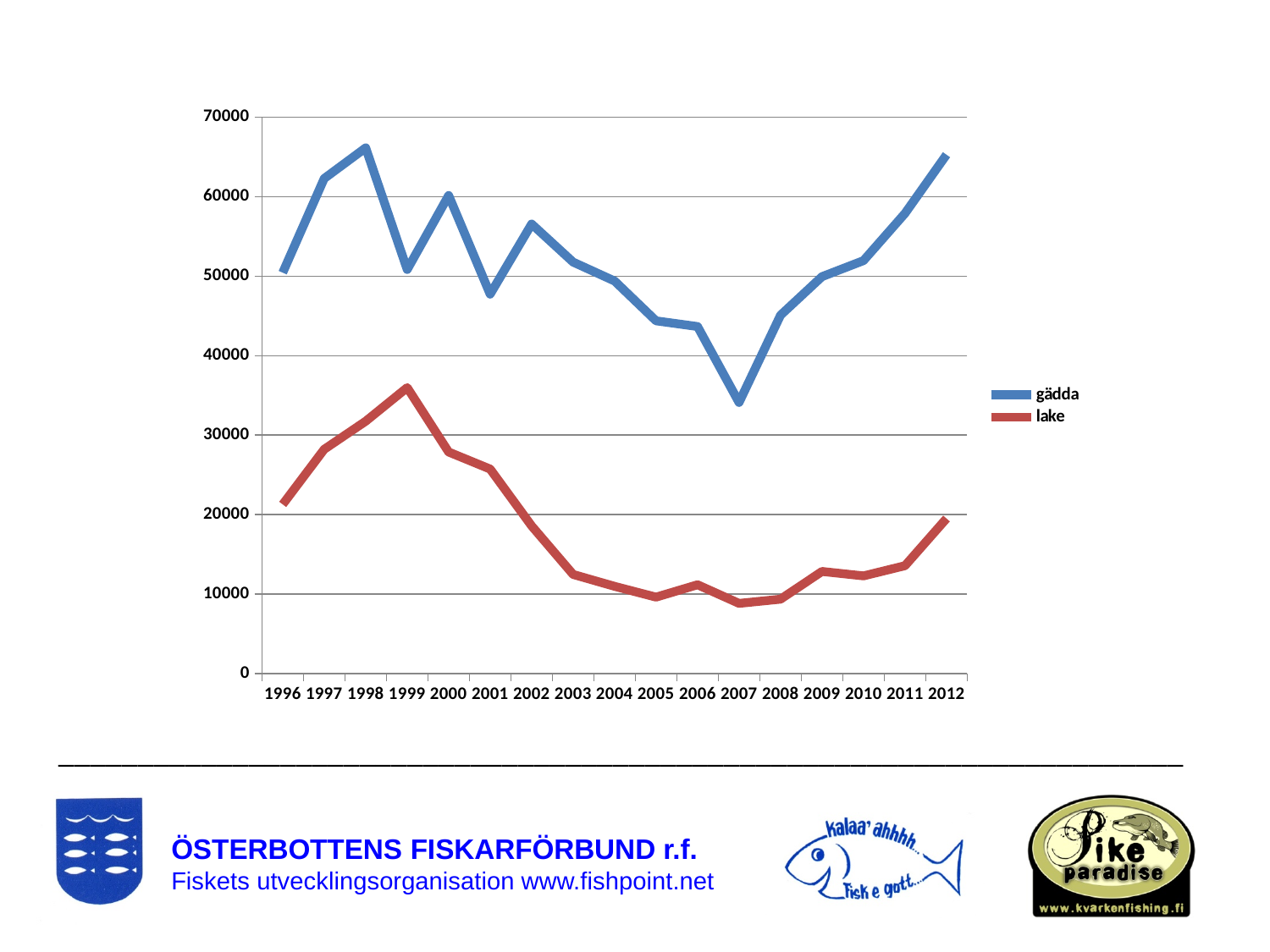
Is the value for lake in 1999 greater or less than 30000? greater Which series has the larger value in 2012, gädda or lake? gädda How many years are shown on the x axis? 17 Does the lake series rise or fall from 1999 to 2005? fall In which year does the lake series reach its highest value? 1999 How many series does the legend list? 2 What kind of chart is shown on the slide? line chart Is the value for gädda in 1998 greater or less than 60000? greater In which year does the gädda series reach its lowest value? 2007 Is the value for gädda in 2007 greater or less than 40000? less Which colour is used for the lake series? red In which year does the gädda series reach its highest value? 1998